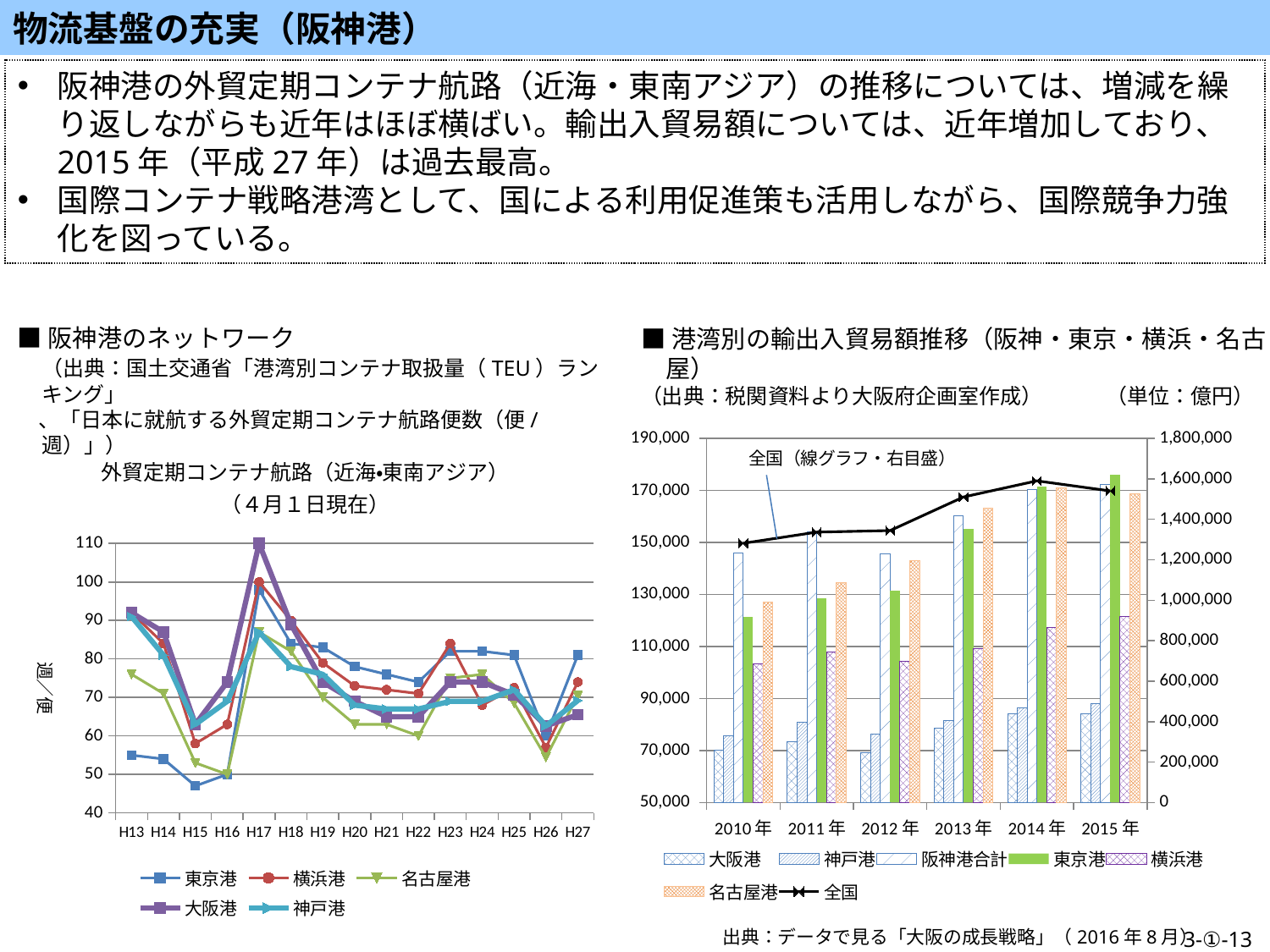
In the right chart (港湾別の輸出入貿易額推移), which is larger in 2010年, 阪神港合計 or 東京港? 阪神港合計 In the left chart (外貿定期コンテナ航路), is the value for 東京港 at H15 greater or less than 50? less How many years are shown on the x axis of the right chart (港湾別の輸出入貿易額推移)? 6 How many series does the legend of the left chart (外貿定期コンテナ航路) list? 5 In the left chart (外貿定期コンテナ航路), which is larger at H13, 大阪港 or 東京港? 大阪港 In the left chart (外貿定期コンテナ航路), does the value for 東京港 rise or fall from H13 to H17? rise What kind of chart is the left chart titled 外貿定期コンテナ航路（近海・東南アジア）? line chart In the left chart (外貿定期コンテナ航路), which port has the lowest value at H13? 東京港 In the right chart (港湾別の輸出入貿易額推移), is the value for 東京港 in 2015年 greater or less than 170,000? greater How many legend entries does the right chart (港湾別の輸出入貿易額推移) list? 7 In the left chart (外貿定期コンテナ航路), is the value for 大阪港 at H17 greater or less than 100? greater How many years are shown on the x axis of the left chart (外貿定期コンテナ航路)? 15